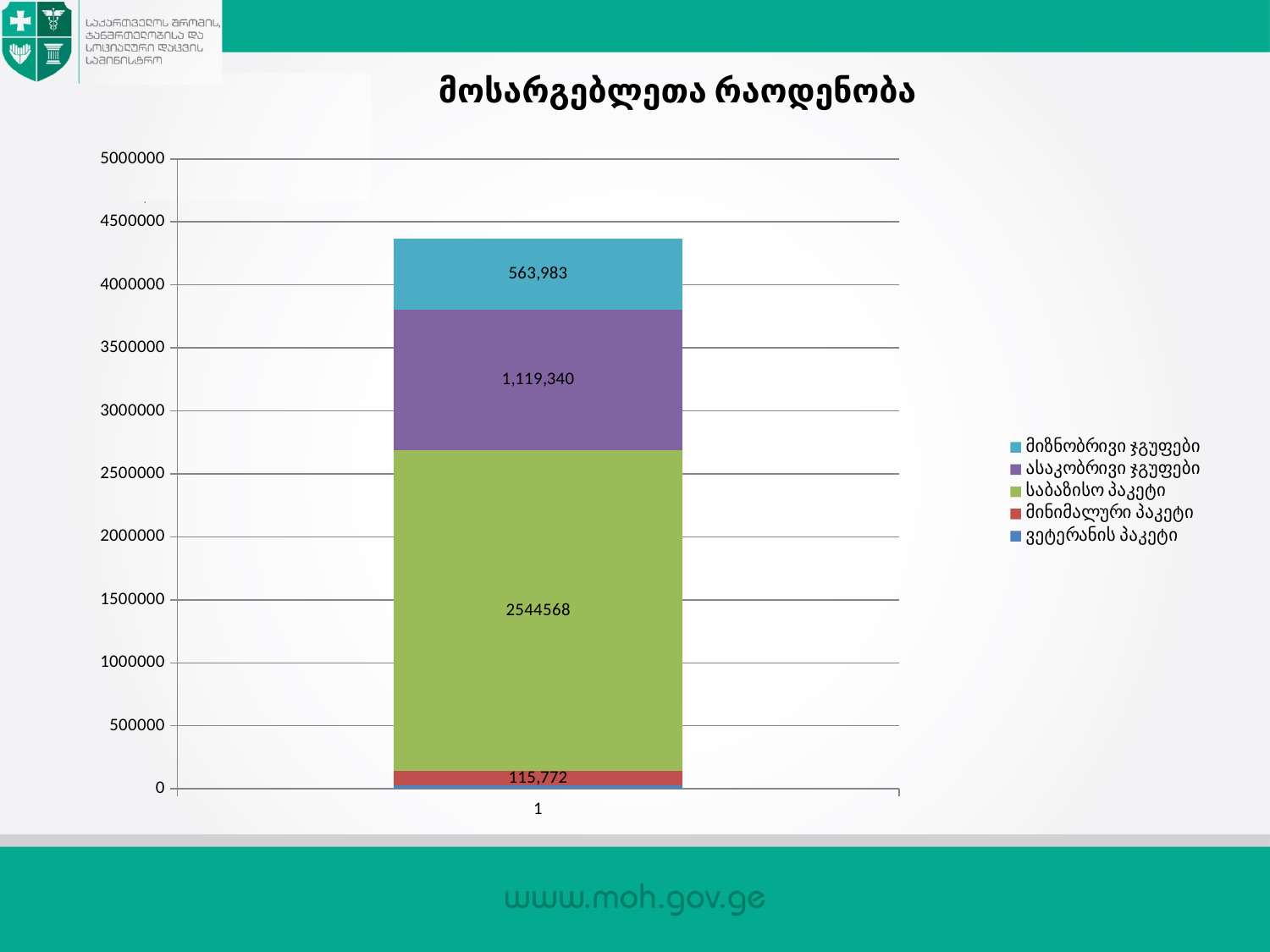
Which series has the smallest segment in the stacked bar? ვეტერანის პაკეტი How many series does the legend list? 5 Which is larger, the value for მიზნობრივი ჯგუფები or the value for მინიმალური პაკეტი? მიზნობრივი ჯგუფები What is the difference between the values for საბაზისო პაკეტი and ასაკობრივი ჯგუფები? 1,425,228 Is the total height of the stacked bar greater or less than 4000000? greater What kind of chart is shown on the slide? stacked bar chart What is the difference between the values for ასაკობრივი ჯგუფები and მიზნობრივი ჯგუფები? 555,357 What is the value for საბაზისო პაკეტი? 2544568 Which series has the largest segment in the stacked bar? საბაზისო პაკეტი What is the value for მინიმალური პაკეტი? 115,772 What is the value for ასაკობრივი ჯგუფები? 1,119,340 What is the value for მიზნობრივი ჯგუფები? 563,983